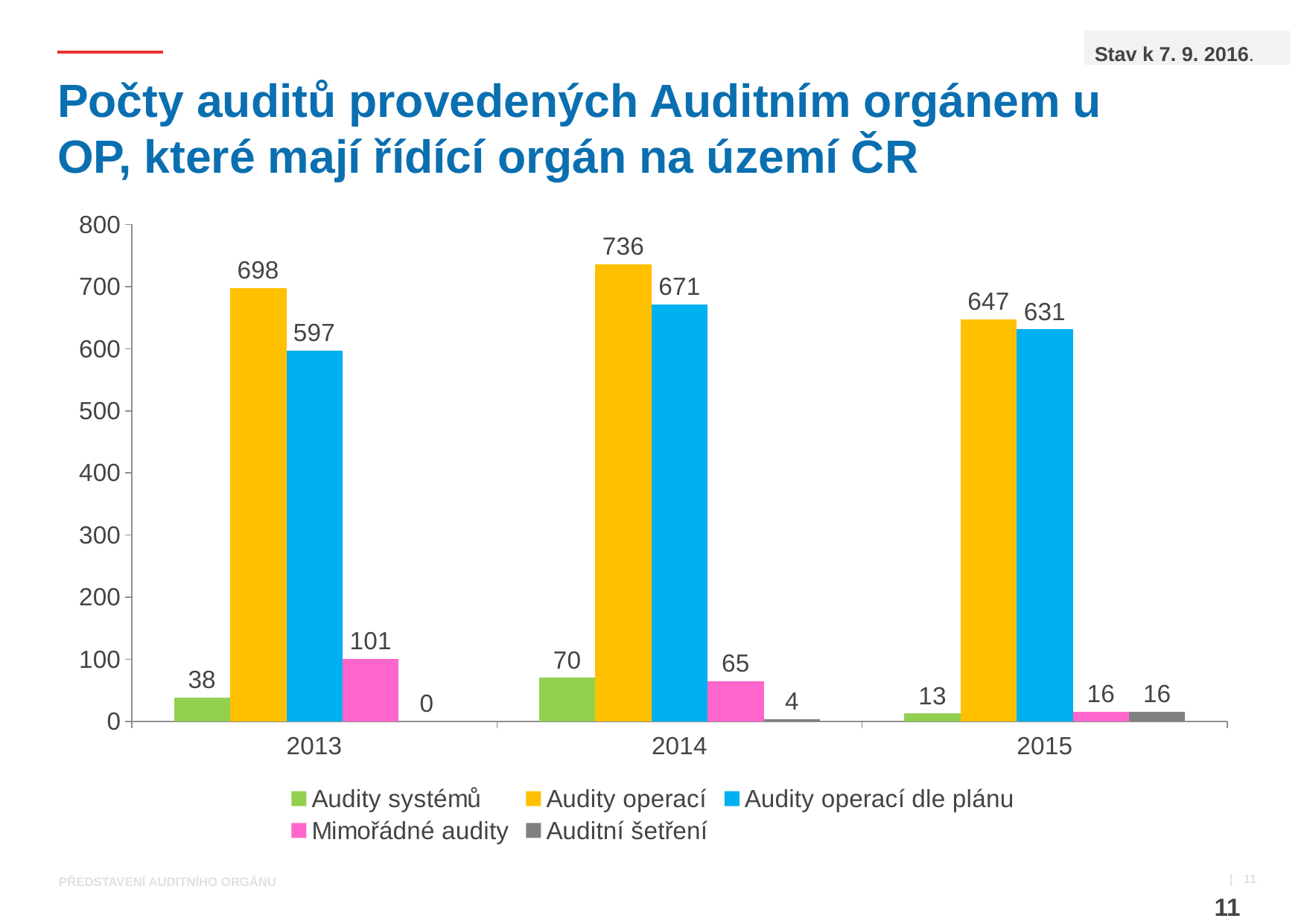
In which year is Audity operací highest? 2014 How many years are shown on the x axis? 3 What is the difference between Audity operací and Audity operací dle plánu in 2013? 101 What is the value for Mimořádné audity in 2015? 16 What kind of chart is shown on the slide? Bar chart How many series does the legend list? 5 In which year is Audity systémů lowest? 2015 Which is larger in 2014: Audity systémů or Mimořádné audity? Audity systémů What is the value for Audity operací in 2014? 736 Do the values for Mimořádné audity rise or fall from 2013 to 2015? Fall What is the value for Audity systémů in 2013? 38 What is the value for Auditní šetření in 2014? 4